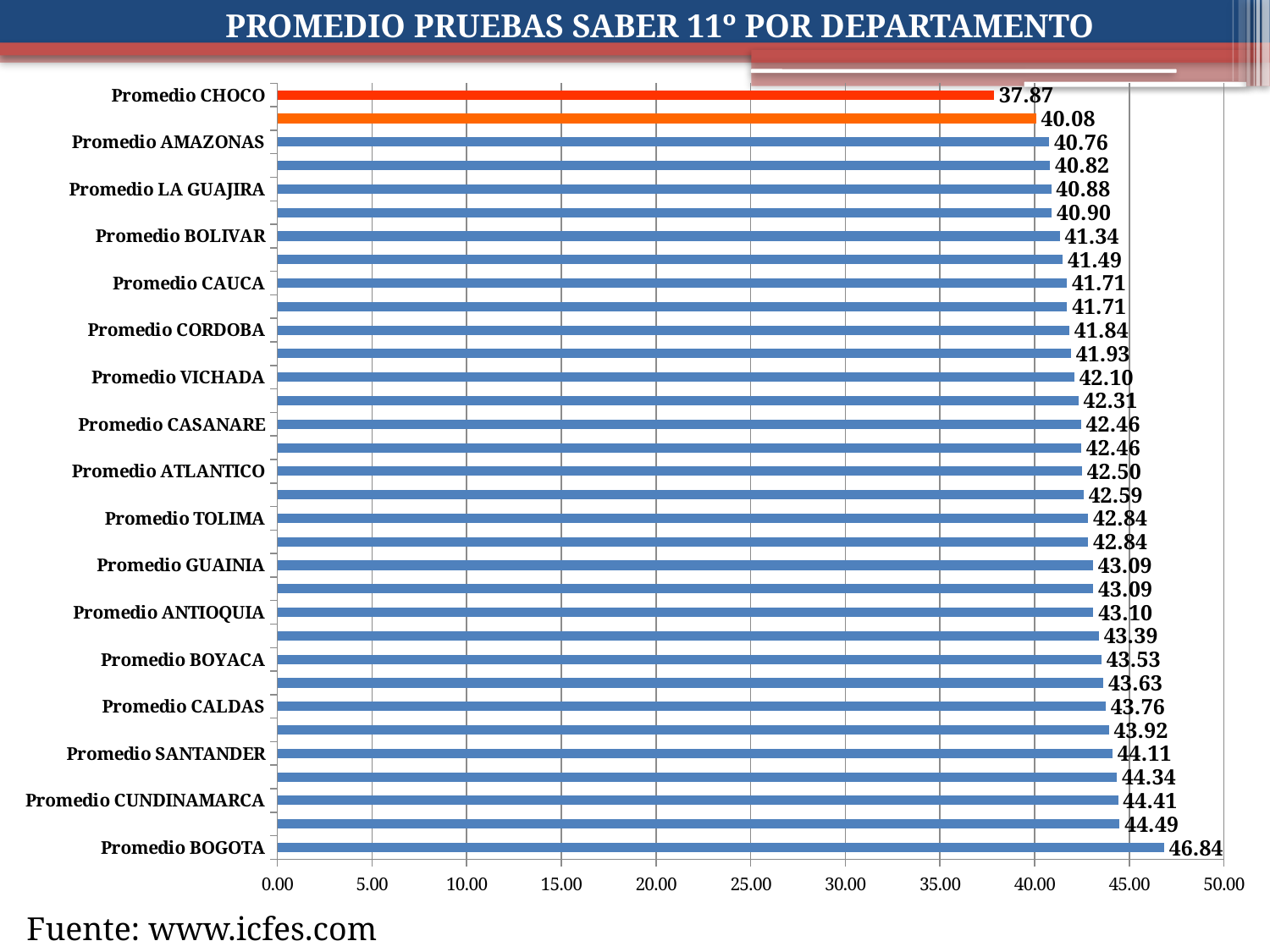
What kind of chart is shown on the slide? bar chart What is the value for Promedio CHOCO? 37.87 What colour is the bar for Promedio CHOCO? red What is the difference between the values for Promedio BOGOTA and Promedio CHOCO? 8.97 What is the value for Promedio LA GUAJIRA? 40.88 Which department has the highest average? Promedio BOGOTA Is the value for Promedio CUNDINAMARCA greater or less than 40.00? greater Which is larger, the value for Promedio SANTANDER or the value for Promedio CAUCA? Promedio SANTANDER What is the value for Promedio BOGOTA? 46.84 What is the title of the chart? PROMEDIO PRUEBAS SABER 11º POR DEPARTAMENTO Which department has the lowest average? Promedio CHOCO What is the value for Promedio ANTIOQUIA? 43.10